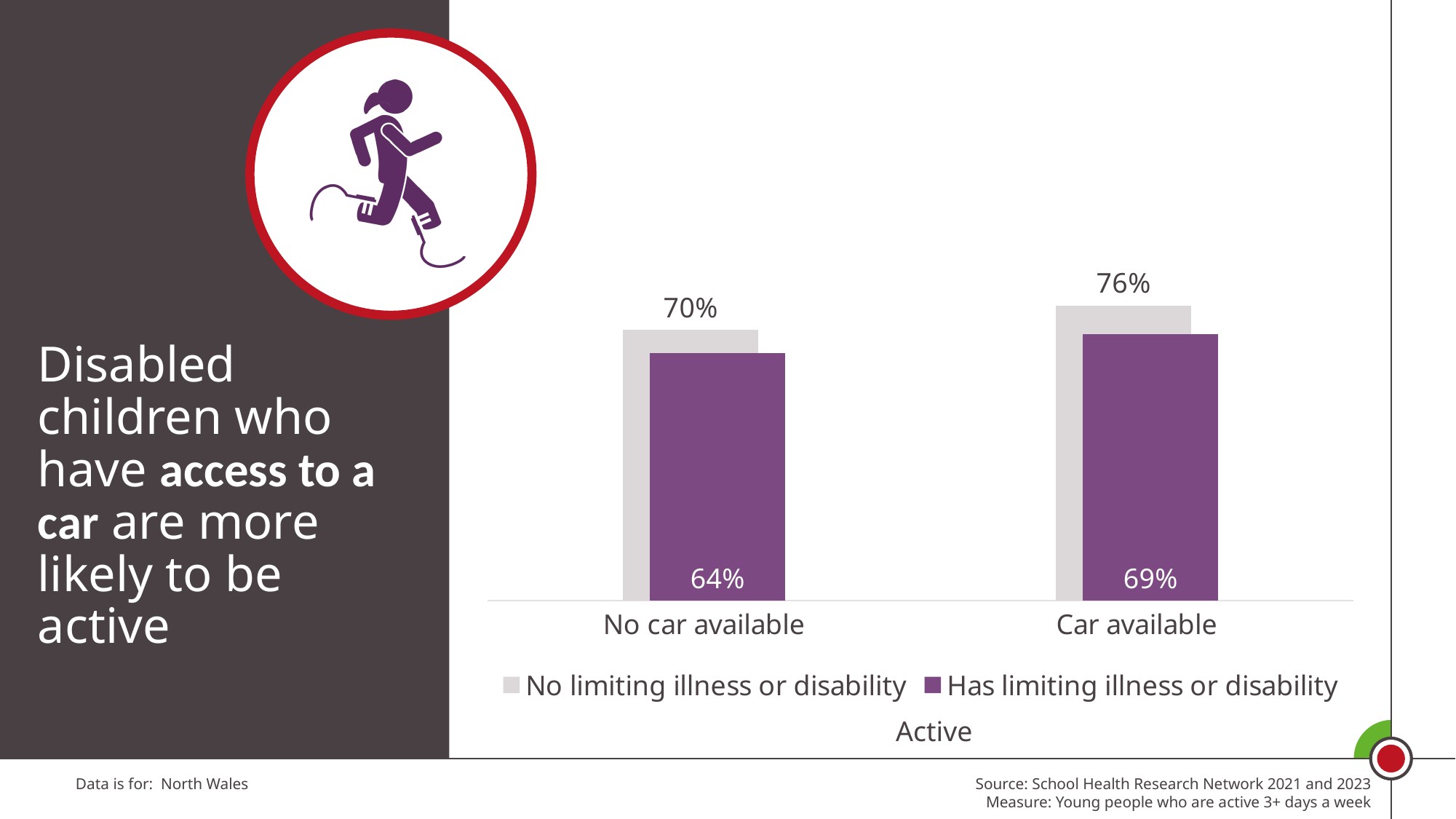
What is the difference between the 'No limiting illness or disability' and 'Has limiting illness or disability' values in the 'Car available' category? 7% What is the value for 'No limiting illness or disability' in the 'Car available' category? 76% What is the difference between the 'Has limiting illness or disability' values for 'Car available' and 'No car available'? 5% How many series does the legend list? 2 Which category has the highest value for 'Has limiting illness or disability'? Car available How many categories are shown on the x axis? 2 In the 'No car available' category, which series has the larger value: 'No limiting illness or disability' or 'Has limiting illness or disability'? No limiting illness or disability Which category has the lowest value for 'No limiting illness or disability'? No car available What is the value for 'No limiting illness or disability' in the 'No car available' category? 70% What is the value for 'Has limiting illness or disability' in the 'No car available' category? 64% What kind of chart is shown on the slide? Bar chart What is the value for 'Has limiting illness or disability' in the 'Car available' category? 69%